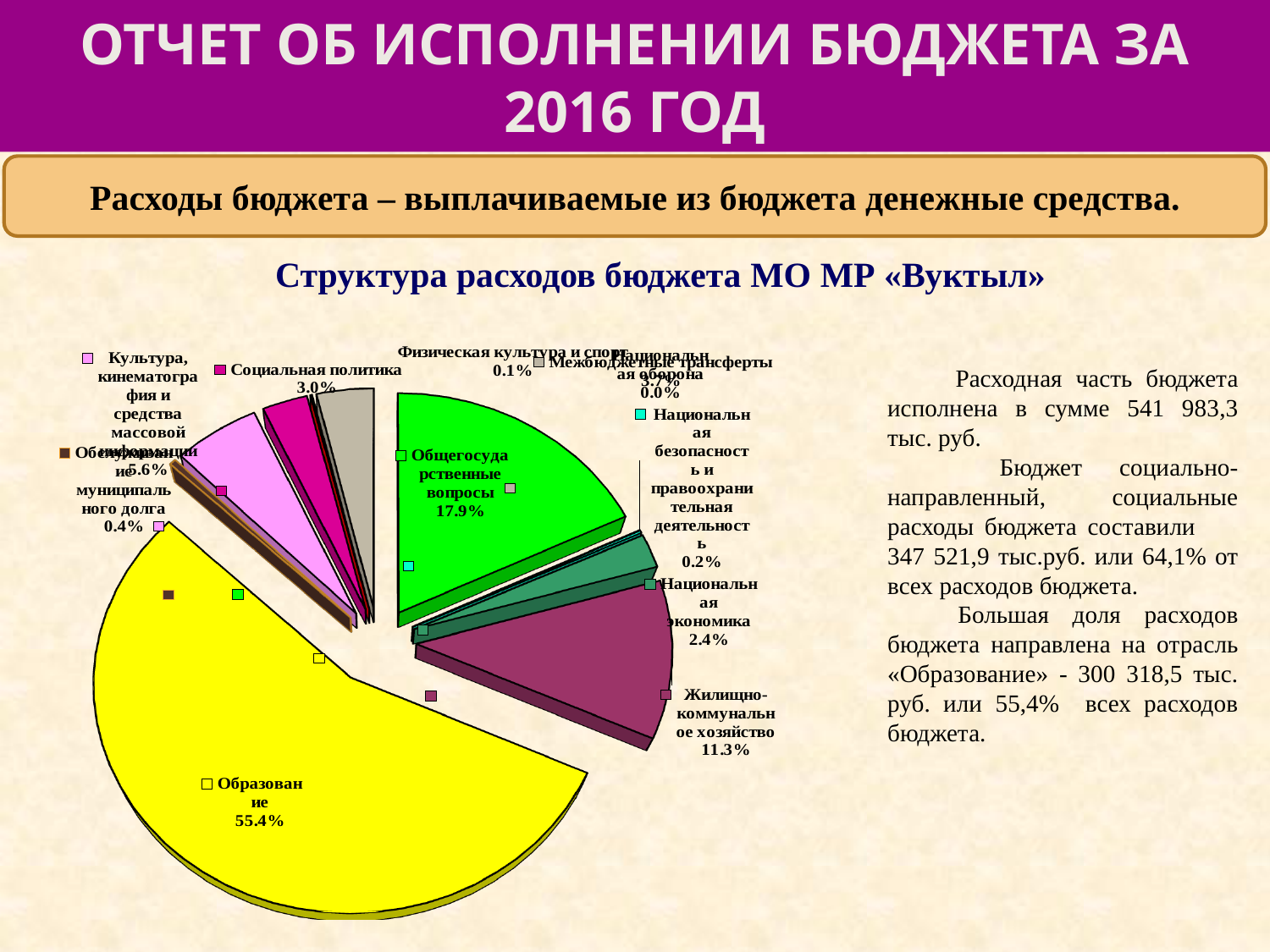
What is the difference between the shares of Образование and Общегосударственные вопросы? 37.5% What is the title of the chart? Структура расходов бюджета МО МР «Вуктыл» What percentage is shown for Межбюджетные трансферты? 3.7% What colour is the Образование slice? Yellow What share of budget expenditures goes to Образование? 55.4% Which category has the largest share of the pie? Образование Which is larger: Общегосударственные вопросы or Жилищно-коммунальное хозяйство? Общегосударственные вопросы What percentage is shown for Жилищно-коммунальное хозяйство? 11.3% What percentage is shown for Социальная политика? 3.0% What type of chart is shown on the slide? Pie chart What share of the pie is Общегосударственные вопросы? 17.9% What percentage is shown for Национальная экономика? 2.4%